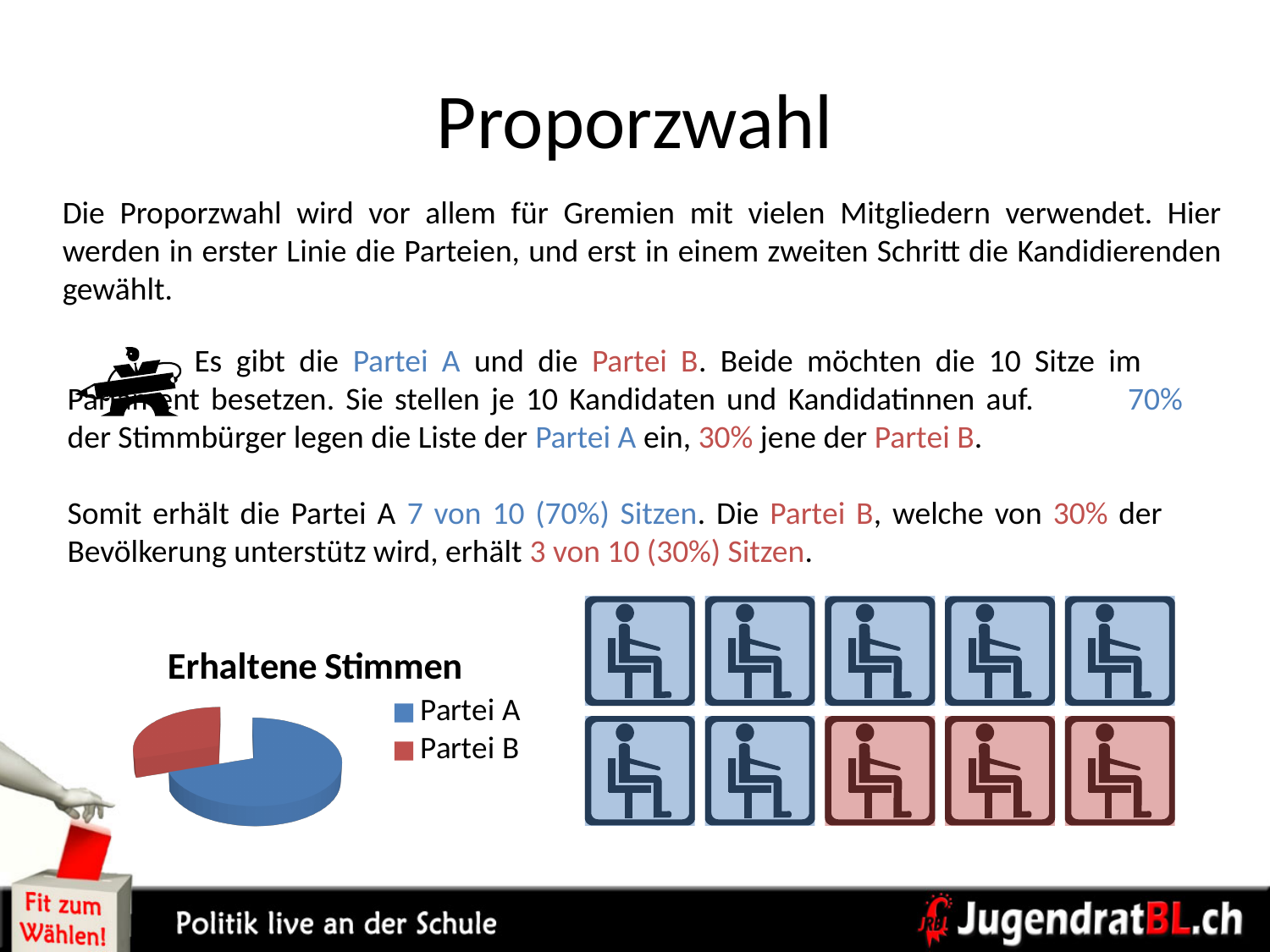
What kind of chart is shown under the title "Erhaltene Stimmen"? pie chart Is the slice for Partei A in the pie chart greater or less than half of the pie? greater Which party has the largest slice in the pie chart? Partei A What colour represents Partei A in the pie chart? blue What is the title of the pie chart on the slide? Erhaltene Stimmen In the pie chart, which slice is larger: Partei A or Partei B? Partei A How many slices does the pie chart have? 2 Which party has the smallest slice in the pie chart? Partei B How many entries does the legend of the pie chart list? 2